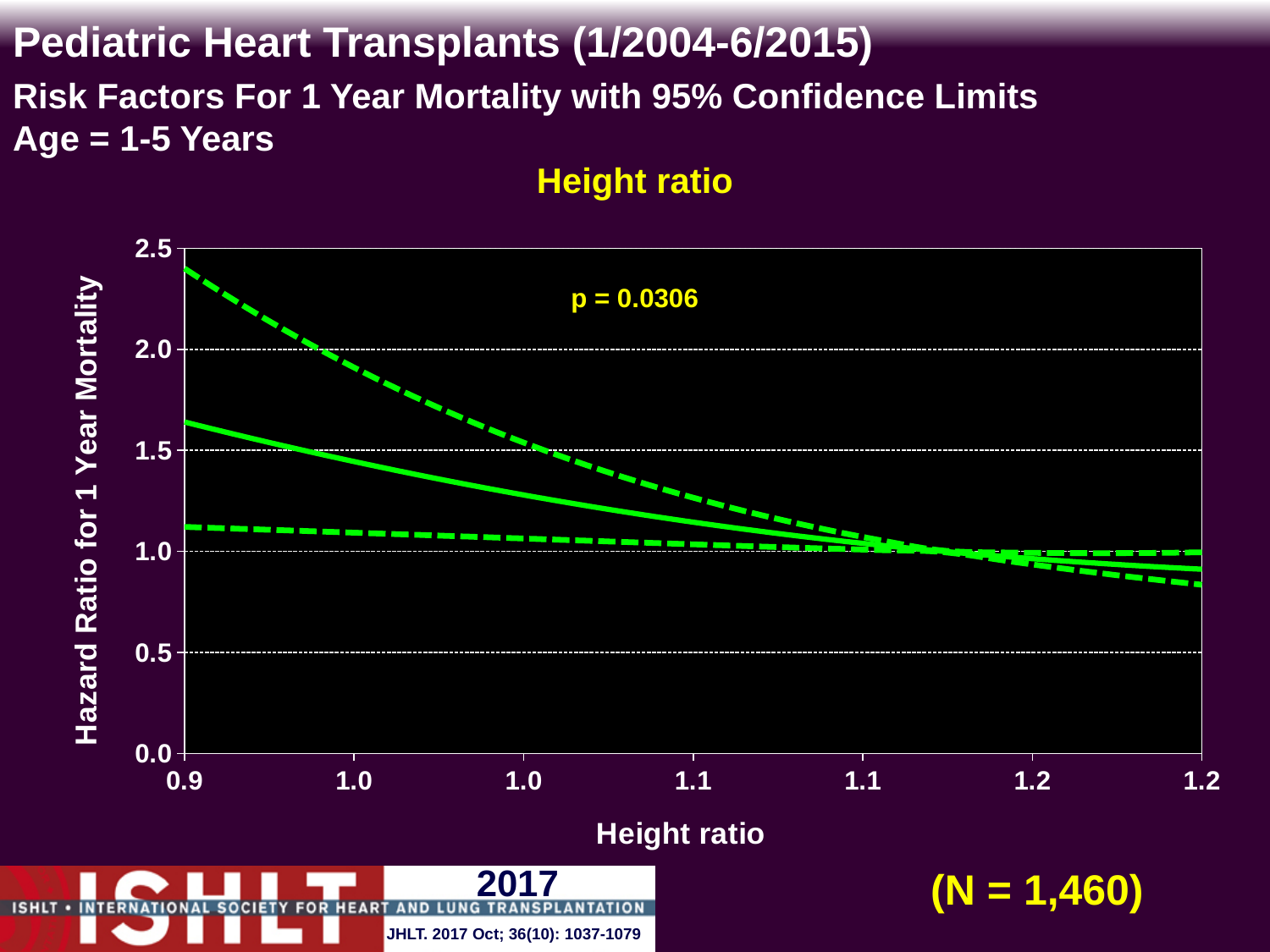
At a height ratio of 0.9, is the value of the solid hazard ratio line greater or less than 1.5? greater At a height ratio of 0.9, which is larger: the upper dashed confidence limit or the solid hazard ratio line? the upper dashed confidence limit At a height ratio of 0.9, is the value of the upper dashed confidence limit greater or less than 2.0? greater What kind of chart is shown on the slide? line chart Does the solid hazard ratio line rise or fall as height ratio increases from 0.9 to 1.2? fall At a height ratio of 0.9, is the value of the lower dashed confidence limit greater or less than 1.0? greater Does the upper dashed confidence limit rise or fall as height ratio increases along the x axis? fall How many lines are plotted on the chart? 3 What p-value is printed on the chart? p = 0.0306 What is the label of the y axis? Hazard Ratio for 1 Year Mortality